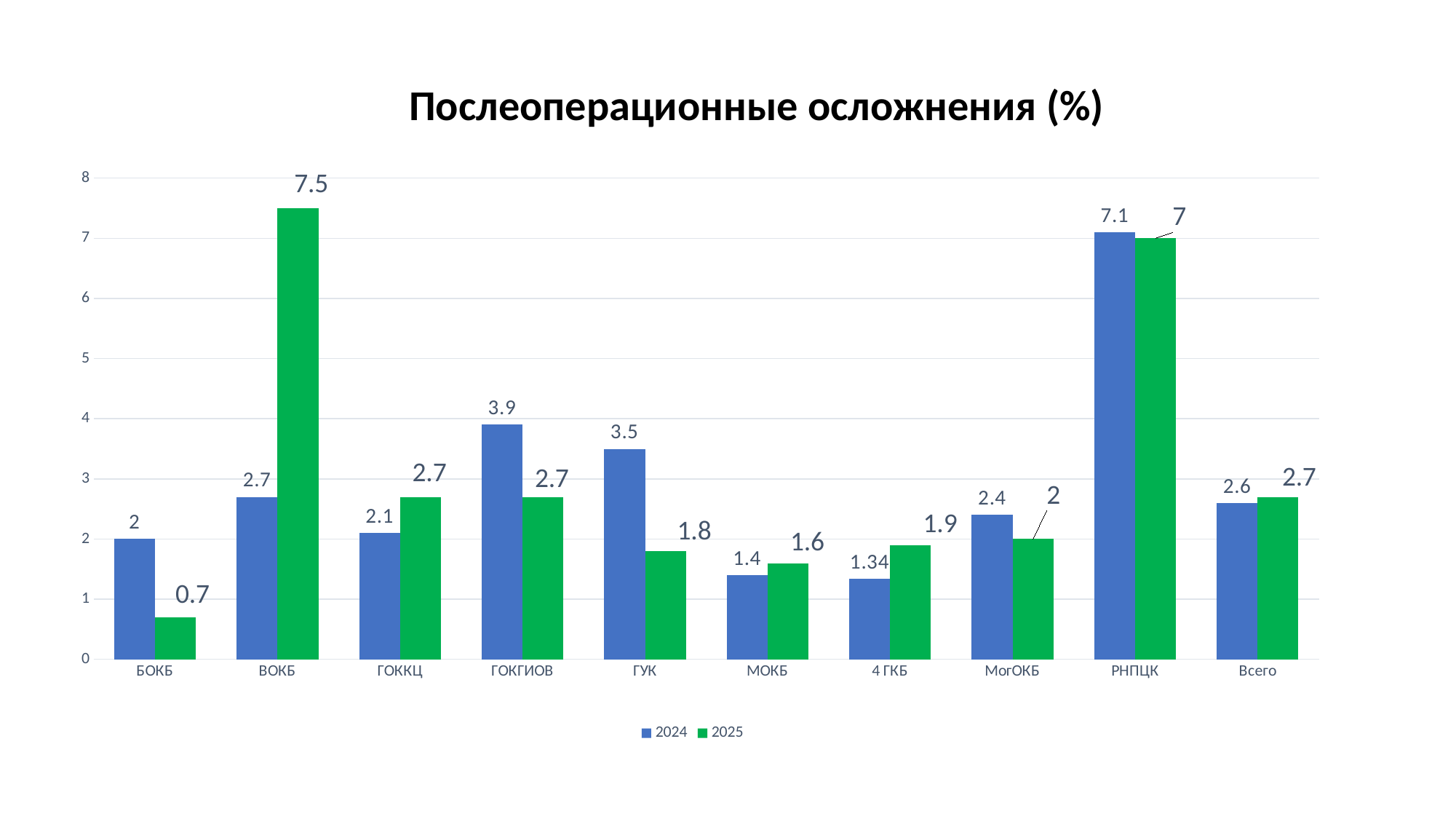
What is the 2025 value for ВОКБ? 7.5 What is the 2025 value for БОКБ? 0.7 How many series does the legend list? 2 What is the 2025 value for Всего? 2.7 What is the difference between the 2024 and 2025 values for ГУК? 1.7 Which is larger for ГОКГИОВ, the 2024 value or the 2025 value? 2024 Which category has the lowest 2025 value? БОКБ What is the 2024 value for 4 ГКБ? 1.34 Which category has the highest 2024 value? РНПЦК What is the title of the chart? Послеоперационные осложнения (%) What kind of chart is shown? bar chart How many categories are shown on the x axis? 10